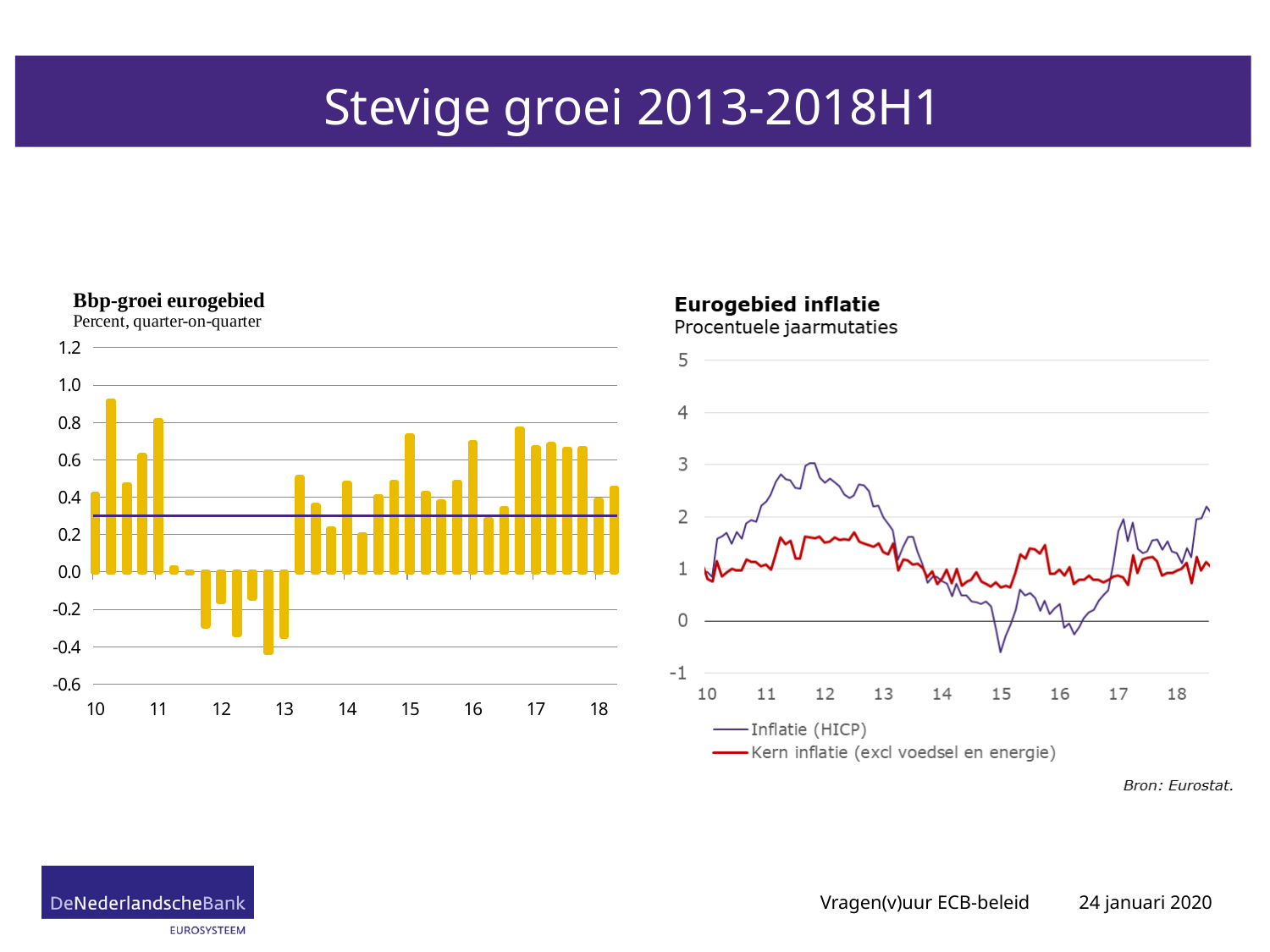
What is the subtitle under the "Bbp-groei eurogebied" chart title? Percent, quarter-on-quarter What kind of chart is the left chart titled "Bbp-groei eurogebied"? bar chart In the "Eurogebied inflatie" chart, does the Kern inflatie line ever rise above 2? No In the "Bbp-groei eurogebied" chart, is the lowest bar greater or less than -0.2? less In the "Bbp-groei eurogebied" chart, in which year label does the tallest bar occur? 10 In the "Bbp-groei eurogebied" chart, is the tallest bar greater or less than 0.8? greater In the "Eurogebied inflatie" chart, which series is drawn in red? Kern inflatie (excl voedsel en energie) What kind of chart is the right chart titled "Eurogebied inflatie"? line chart How many series does the legend of the "Eurogebied inflatie" chart list? 2 In the "Eurogebied inflatie" chart, does the Inflatie (HICP) line rise or fall between the 12 and 15 labels on the x axis? fall